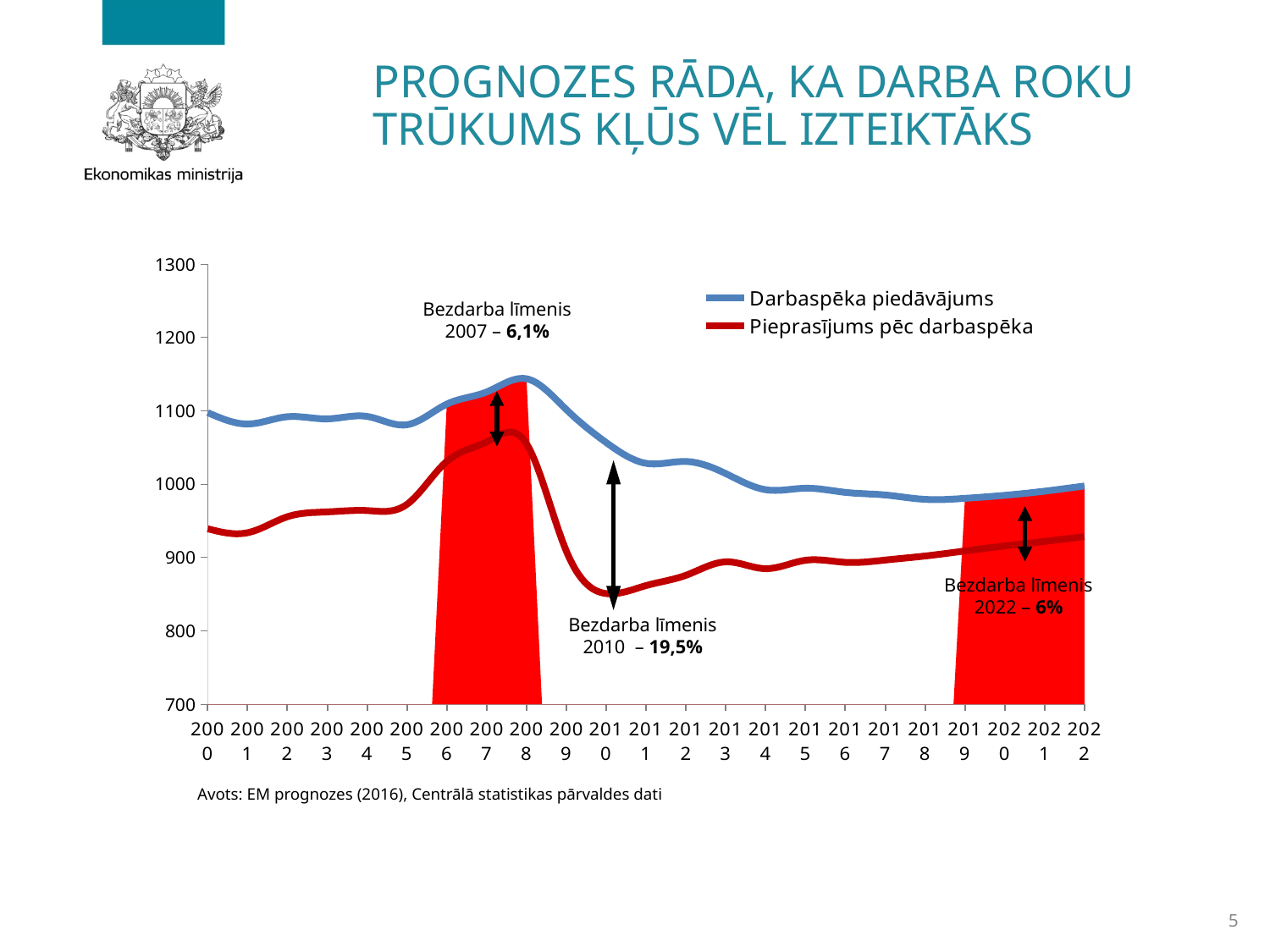
In which year does Darbaspēka piedāvājums reach its highest value? 2008 What unemployment rate (Bezdarba līmenis) is annotated for 2010? 19,5% How many series does the chart legend list? 2 What unemployment rate (Bezdarba līmenis) is annotated for 2007? 6,1% In which year does Pieprasījums pēc darbaspēka reach its lowest value? 2010 Is the value of Pieprasījums pēc darbaspēka in 2010 greater or less than 900? less What are the two series named in the legend? Darbaspēka piedāvājums; Pieprasījums pēc darbaspēka What kind of chart is shown on the slide? line chart How many years are shown along the x axis? 23 What unemployment rate (Bezdarba līmenis) is annotated for 2022? 6% Is the value of Darbaspēka piedāvājums in 2008 greater or less than 1100? greater Does Pieprasījums pēc darbaspēka rise or fall between 2008 and 2010? fall